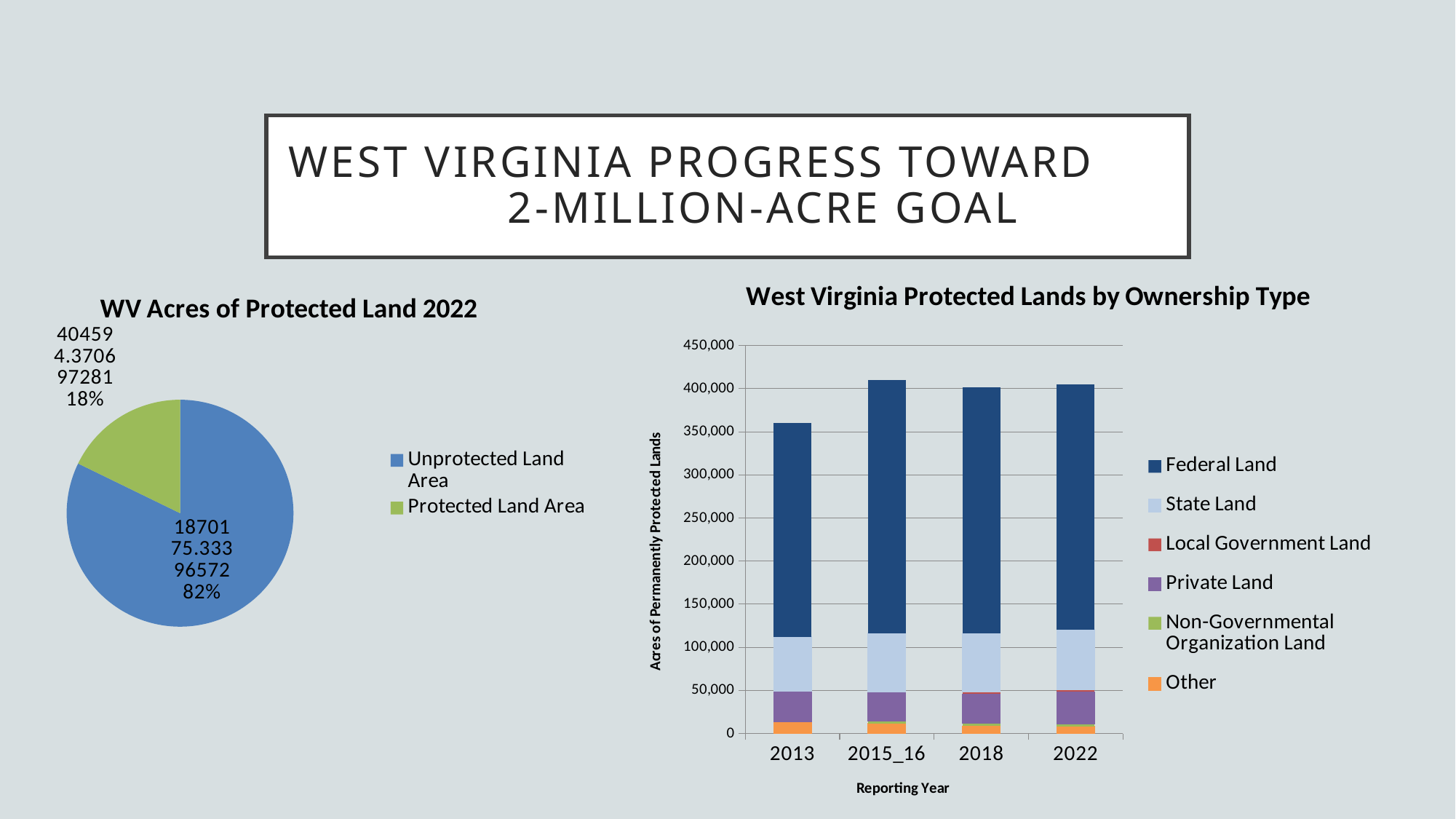
In 'West Virginia Protected Lands by Ownership Type', which reporting year has the lowest total stacked bar? 2013 In the pie chart 'WV Acres of Protected Land 2022', what share of the pie is Unprotected Land Area? 82% How many series does the legend of 'West Virginia Protected Lands by Ownership Type' list? 6 In 'West Virginia Protected Lands by Ownership Type', is the total for 2013 greater or less than 400,000? less In 'West Virginia Protected Lands by Ownership Type', which ownership type makes up the largest portion of every bar? Federal Land In 'West Virginia Protected Lands by Ownership Type', is the total for 2015_16 greater or less than 400,000? greater How many slices does the pie chart 'WV Acres of Protected Land 2022' have? 2 In the pie chart 'WV Acres of Protected Land 2022', what share of the pie is Protected Land Area? 18% What kind of chart is 'WV Acres of Protected Land 2022'? Pie chart What kind of chart is 'West Virginia Protected Lands by Ownership Type'? Stacked bar chart How many reporting years are shown on the x axis of 'West Virginia Protected Lands by Ownership Type'? 4 In the pie chart 'WV Acres of Protected Land 2022', which slice is larger: Unprotected Land Area or Protected Land Area? Unprotected Land Area